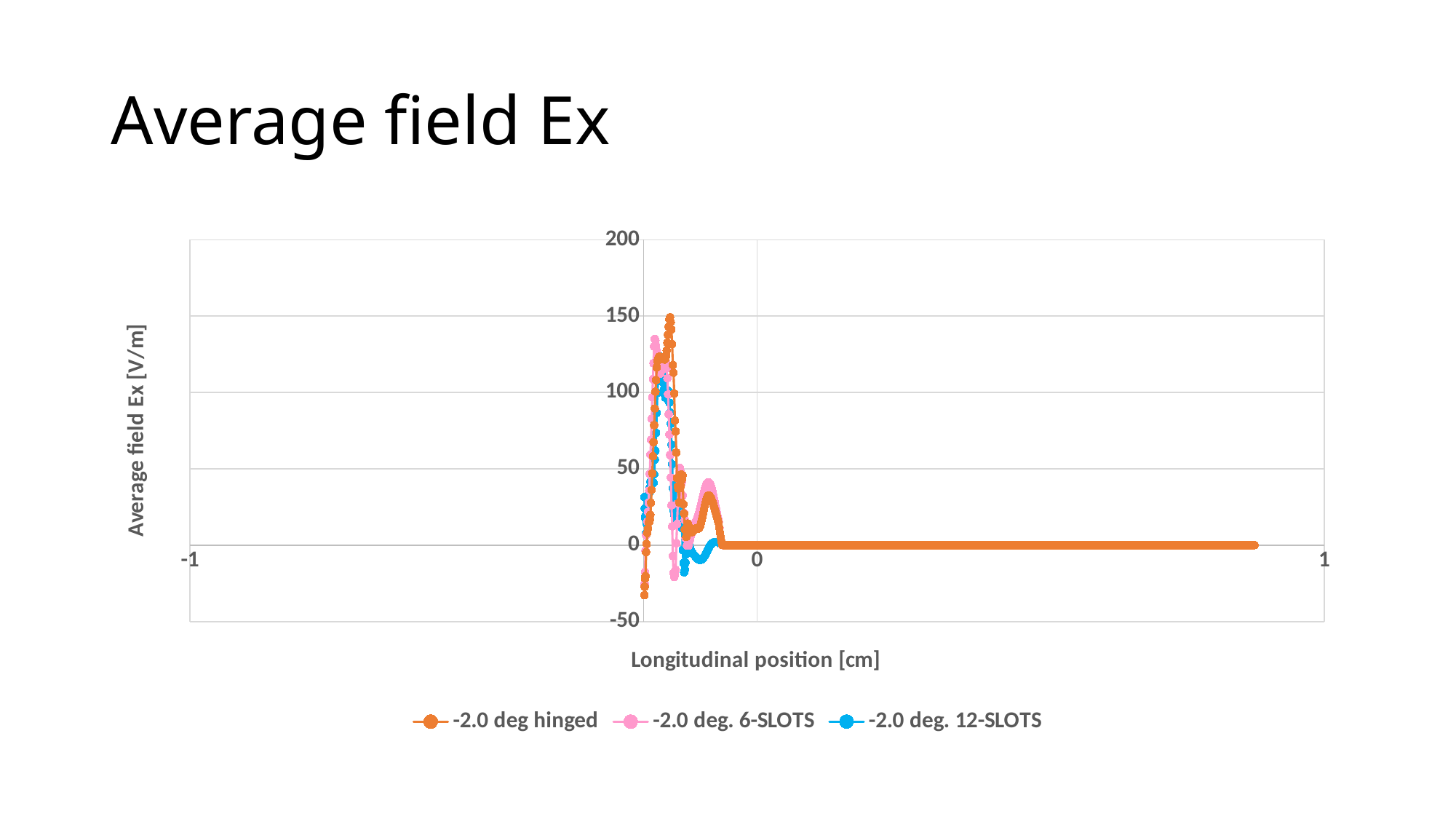
Which series has the lowest peak value? -2.0 deg. 12-SLOTS Which series has the higher peak, -2.0 deg. 6-SLOTS or -2.0 deg. 12-SLOTS? -2.0 deg. 6-SLOTS What is the title of the chart's x axis? Longitudinal position [cm] Is the peak value of the -2.0 deg hinged series greater or less than 100? greater Is the lowest value of the -2.0 deg hinged series greater or less than 0? less What kind of chart is shown on the slide? line chart What is the title of the chart's y axis? Average field Ex [V/m] Is the lowest value of the -2.0 deg hinged series greater or less than -50? greater Which series reaches the highest peak value? -2.0 deg hinged Do the values rise, fall, or stay flat along the x axis for positions greater than 0? stay flat How many series does the legend list? 3